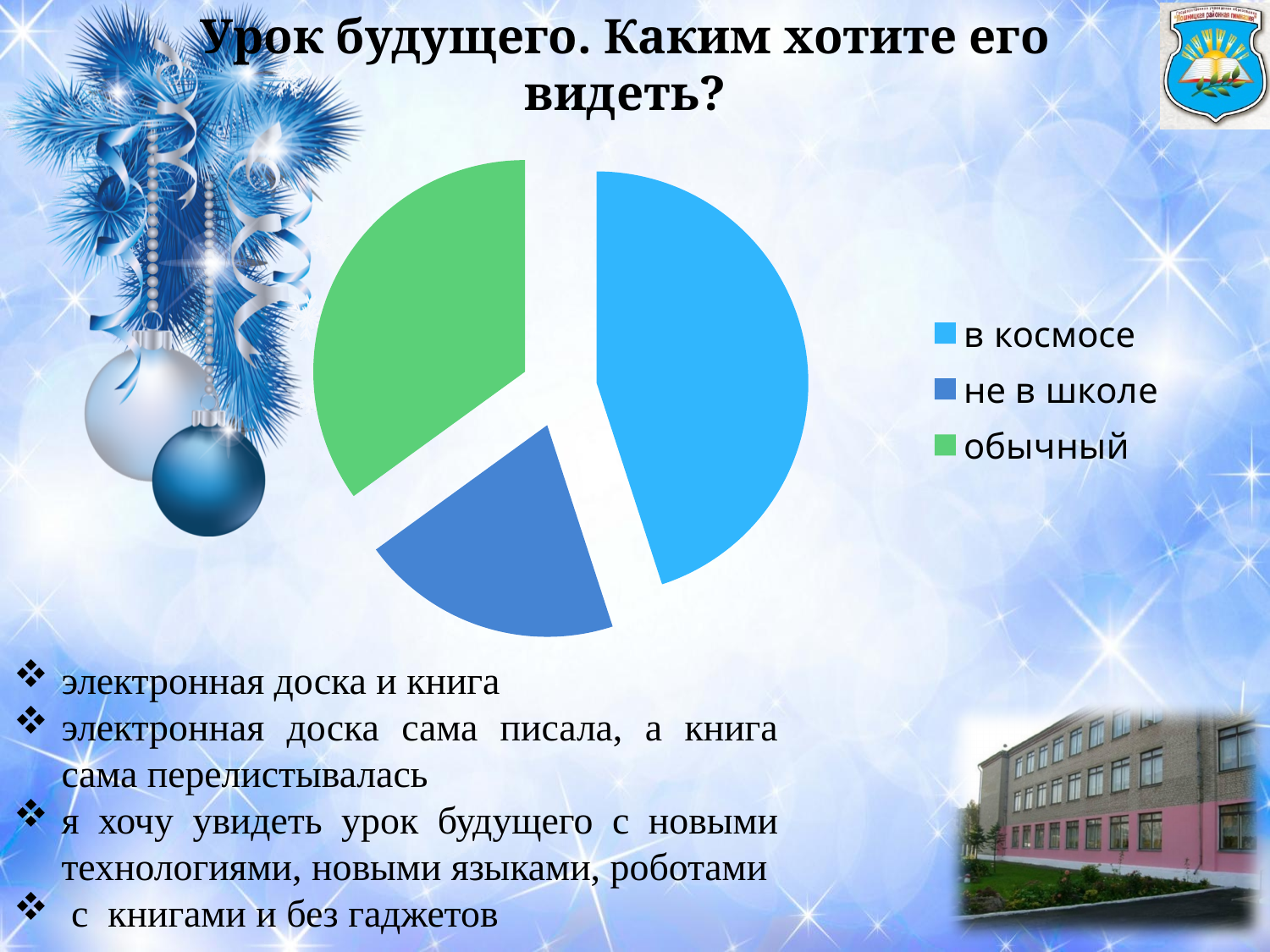
How many entries does the legend of the pie chart list? 3 What colour is the "обычный" slice in the pie chart? green Which category has the smallest slice of the pie chart? не в школе How many slices does the pie chart have? 3 Which category has the largest slice of the pie chart? в космосе What kind of chart is shown on the slide? pie chart What is the title of the slide containing the pie chart? Урок будущего. Каким хотите его видеть? Which slice is larger: "обычный" or "не в школе"? обычный Which slice is larger: "в космосе" or "не в школе"? в космосе